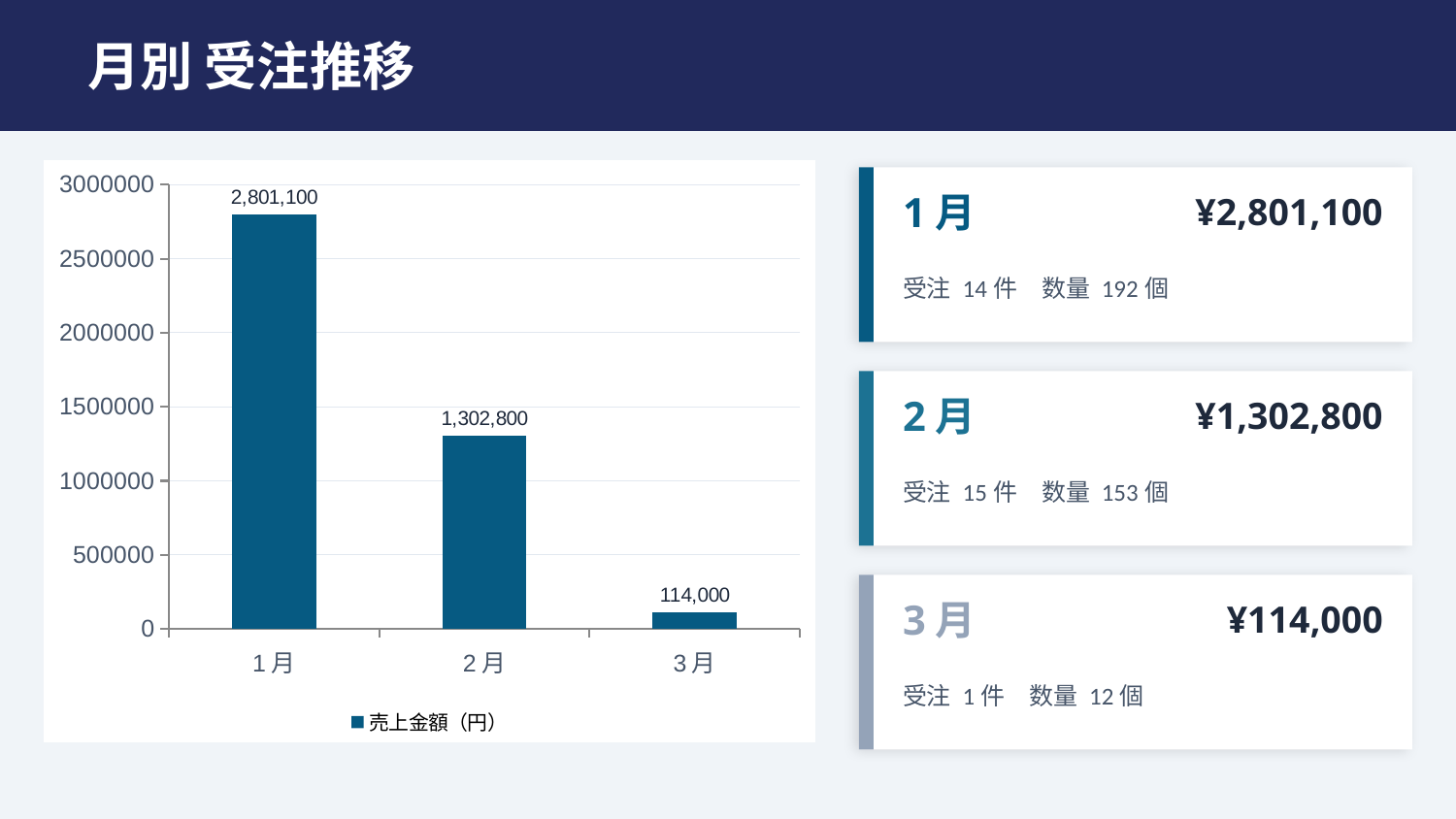
What kind of chart is shown on the slide? bar chart Which month has the highest value in the chart? 1月 What is the difference between the values for 2月 and 3月? 1,188,800 Is the value for 2月 greater or less than 1500000? less Do the values rise or fall from 1月 to 3月? fall Which month has the lowest value in the chart? 3月 What is the difference between the values for 1月 and 2月? 1,498,300 What is the value for 3月 in the chart? 114,000 Which is larger, the value for 2月 or the value for 3月? 2月 How many months are shown on the x axis of the chart? 3 What is the value for 1月 in the chart? 2,801,100 What is the value for 2月 in the chart? 1,302,800